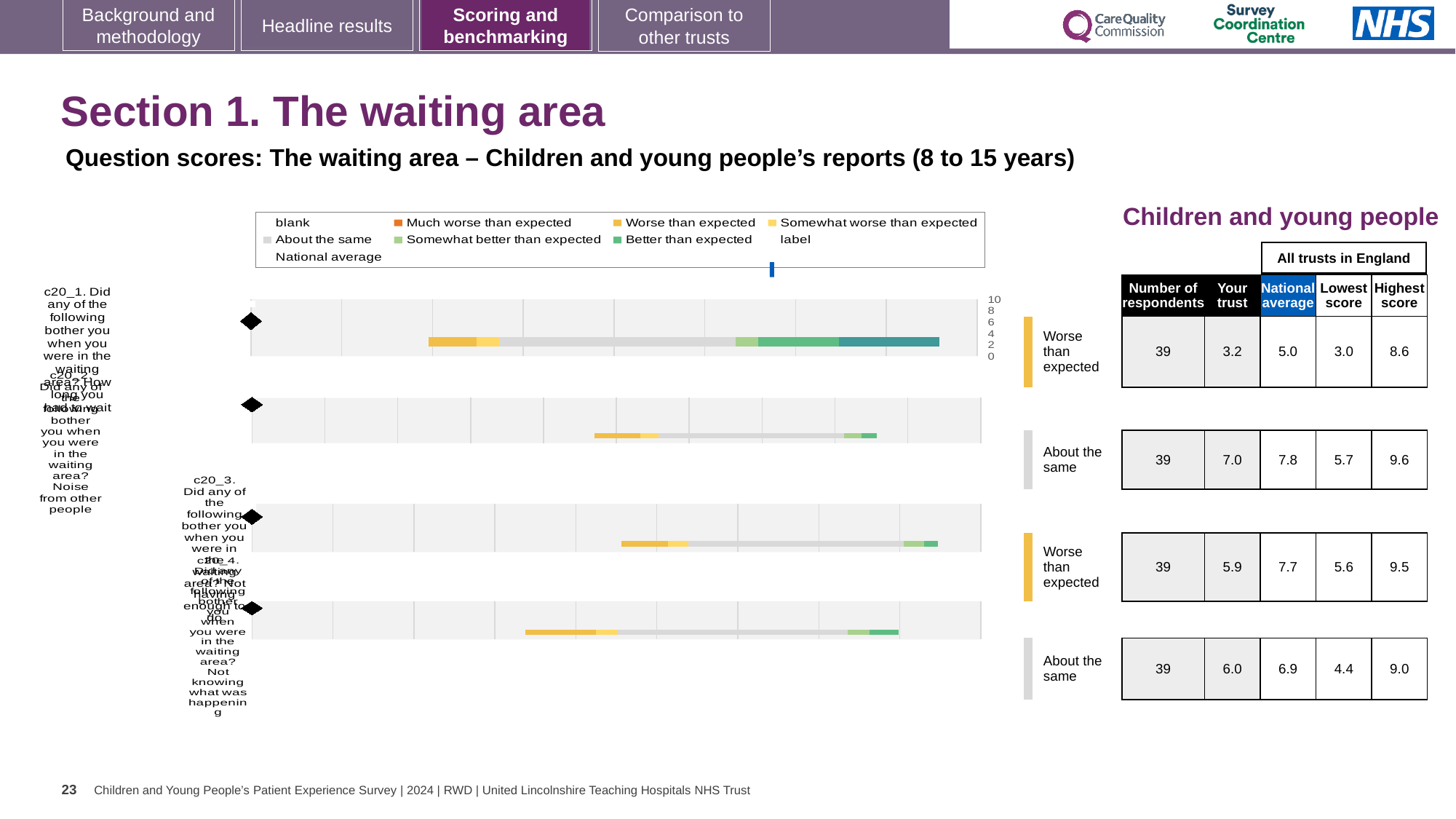
What is the difference between the national average and the 'Your trust' score for the top chart's question? 1.8 What benchmark label is shown beside the top bar chart? Worse than expected In the table next to the charts, what is the highest score for the third chart's question? 9.5 In the table next to the charts, what is the national average for the second chart's question? 7.8 What benchmark label is shown beside the second bar chart from the top? About the same Which of the four charted questions has the highest 'Your trust' score in the table? the second chart (7.0) How many respondents are listed for each of the four questions charted? 39 Which of the four charted questions has the lowest 'Your trust' score in the table? the top chart (3.2) In the table next to the charts, what is the lowest score for the bottom chart's question? 4.4 In the table next to the charts, what is the 'Your trust' score for the top chart's question? 3.2 How many separate bar charts are shown on the slide? 4 What kind of chart is used to show the question scores on this slide? bar chart